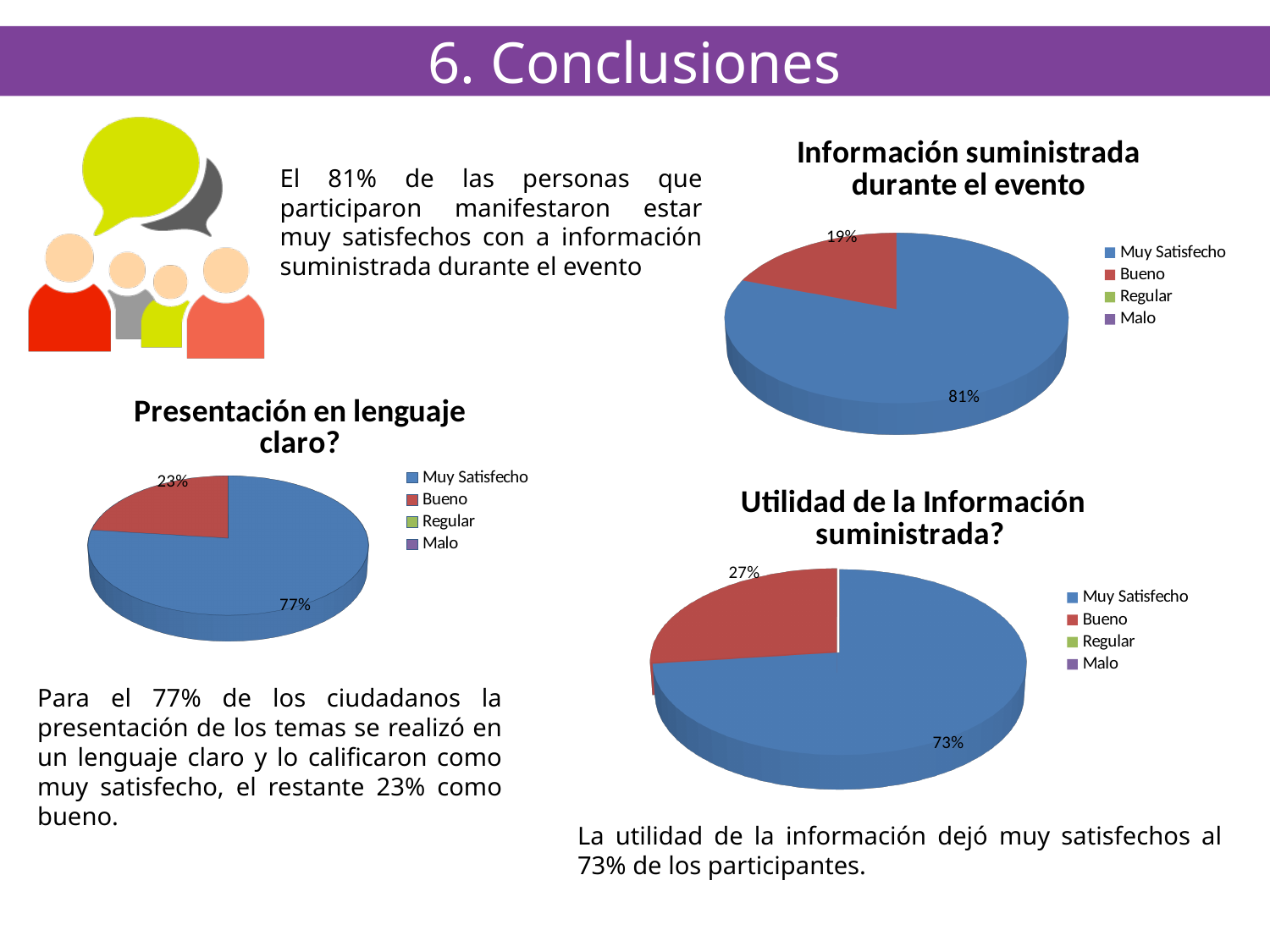
In the 'Presentación en lenguaje claro?' chart, what share is labelled for Muy Satisfecho? 77% In the 'Utilidad de la Información suministrada?' chart, what share is labelled for Muy Satisfecho? 73% In the 'Presentación en lenguaje claro?' chart, what share is labelled for Bueno? 23% In the 'Información suministrada durante el evento' chart, what share is labelled for Muy Satisfecho? 81% In the 'Presentación en lenguaje claro?' chart, what is the difference between the Muy Satisfecho and Bueno shares? 54% In the 'Utilidad de la Información suministrada?' chart, which category has the largest slice? Muy Satisfecho In the 'Información suministrada durante el evento' chart, what share is labelled for Bueno? 19% What kind of chart is 'Presentación en lenguaje claro?'? Pie chart How many entries does the legend of the 'Utilidad de la Información suministrada?' chart list? 4 In the 'Información suministrada durante el evento' chart, what colour is the Bueno slice? Red In the 'Utilidad de la Información suministrada?' chart, what share is labelled for Bueno? 27% In the 'Información suministrada durante el evento' chart, which is larger, the Muy Satisfecho slice or the Bueno slice? Muy Satisfecho